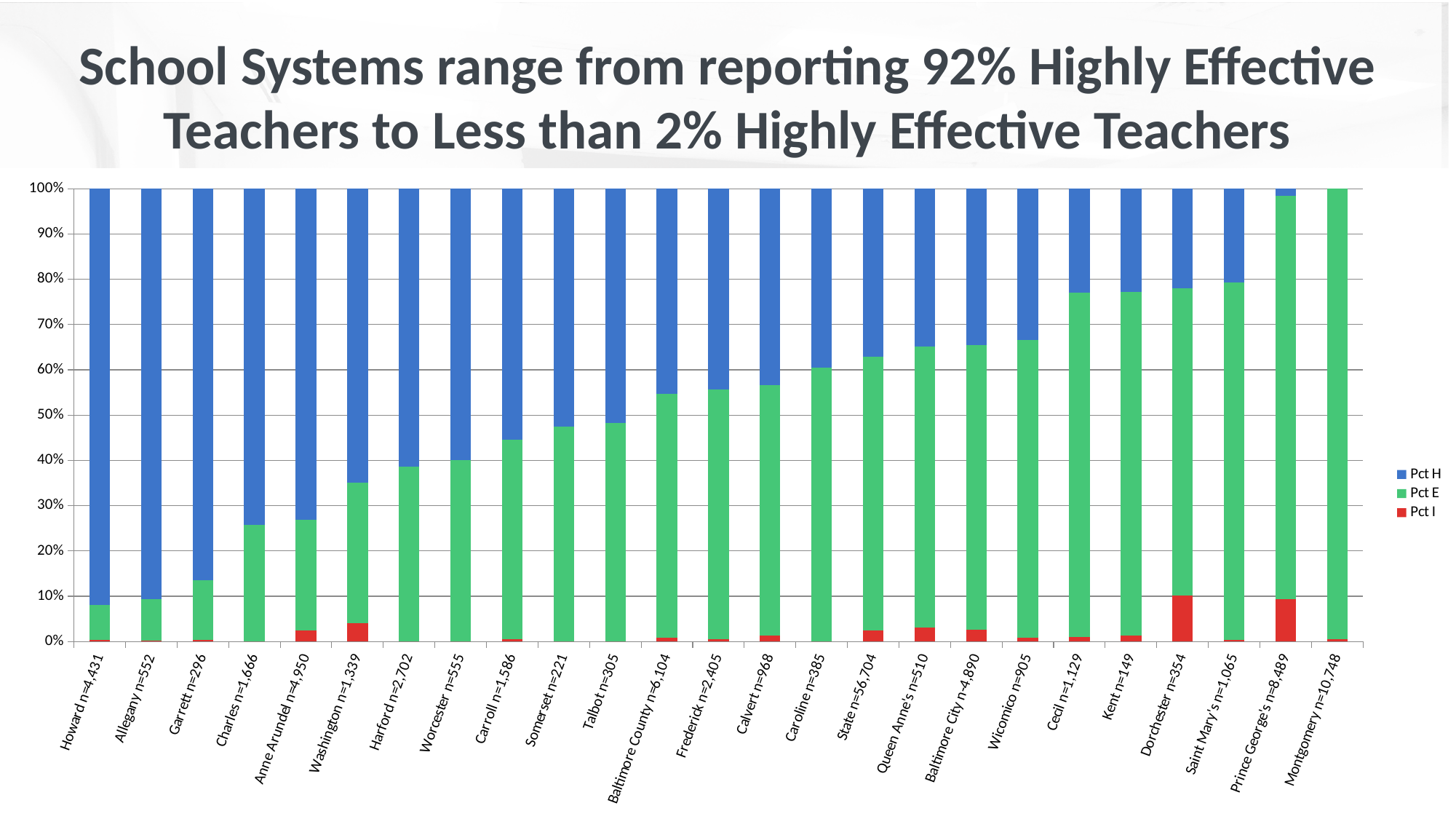
Is the Pct E value for Howard n=4,431 greater or less than 10%? less Which is larger, the Pct I value for Dorchester n=354 or for Howard n=4,431? Dorchester n=354 How many series does the legend list? 3 Which category has the largest Pct E segment? Montgomery n=10,748 Is the Pct E value for Montgomery n=10,748 greater or less than 90%? greater What is the total of the stacked bar for Howard n=4,431? 100% What kind of chart is shown on the slide? stacked bar chart Is the Pct E value for Charles n=1,666 greater or less than 30%? less Does the Pct H series generally rise or fall moving from left to right along the x axis? fall Which series is shown in green in the legend? Pct E How many school system categories are plotted along the x axis? 25